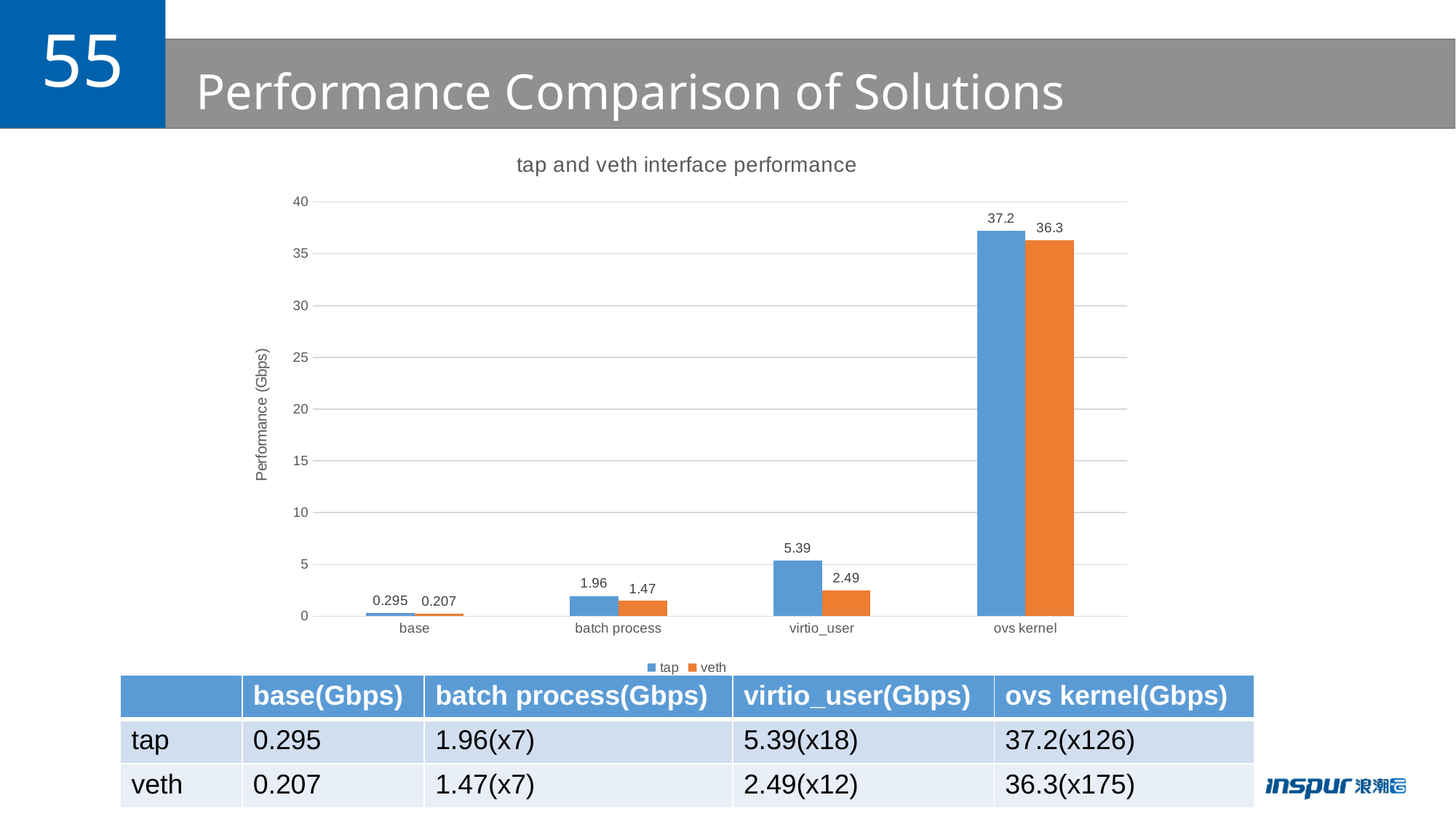
Which is larger for batch process, the tap value or the veth value? tap What is the tap value for virtio_user? 5.39 How many series does the legend list? 2 What is the difference between the tap and veth values for virtio_user? 2.9 Which category has the lowest veth value? base What kind of chart is shown? bar chart What is the veth value for ovs kernel? 36.3 Which category has the highest tap value? ovs kernel Is the tap value for ovs kernel greater or less than 35? greater What is the title of the chart? tap and veth interface performance How many categories are shown on the x axis? 4 What is the veth value for batch process? 1.47